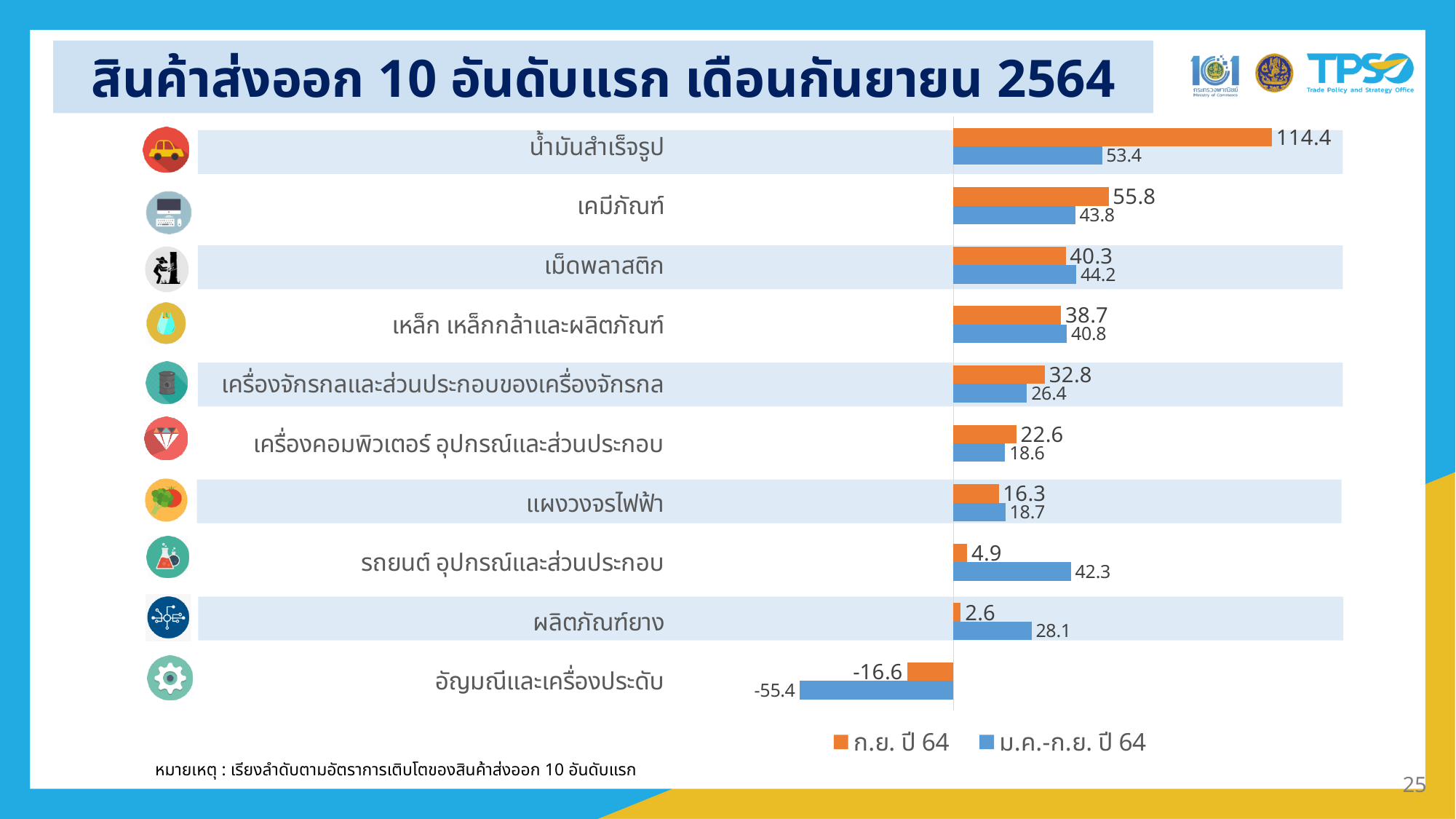
Which category has the highest value in the ก.ย. ปี 64 series? น้ำมันสำเร็จรูป What is the difference between the ก.ย. ปี 64 and ม.ค.-ก.ย. ปี 64 values for น้ำมันสำเร็จรูป? 61.0 Which colour represents the ก.ย. ปี 64 series in the legend? Orange What is the value for เคมีภัณฑ์ in the ม.ค.-ก.ย. ปี 64 series? 43.8 How many product categories are shown in the chart? 10 For ผลิตภัณฑ์ยาง, which series has the larger value: ก.ย. ปี 64 or ม.ค.-ก.ย. ปี 64? ม.ค.-ก.ย. ปี 64 What is the value for รถยนต์ อุปกรณ์และส่วนประกอบ in the ม.ค.-ก.ย. ปี 64 series? 42.3 What is the value for น้ำมันสำเร็จรูป in the ก.ย. ปี 64 series? 114.4 Which category has the lowest value in the ม.ค.-ก.ย. ปี 64 series? อัญมณีและเครื่องประดับ What is the value for อัญมณีและเครื่องประดับ in the ม.ค.-ก.ย. ปี 64 series? -55.4 What kind of chart is shown on the slide? Bar chart How many series does the legend list? 2